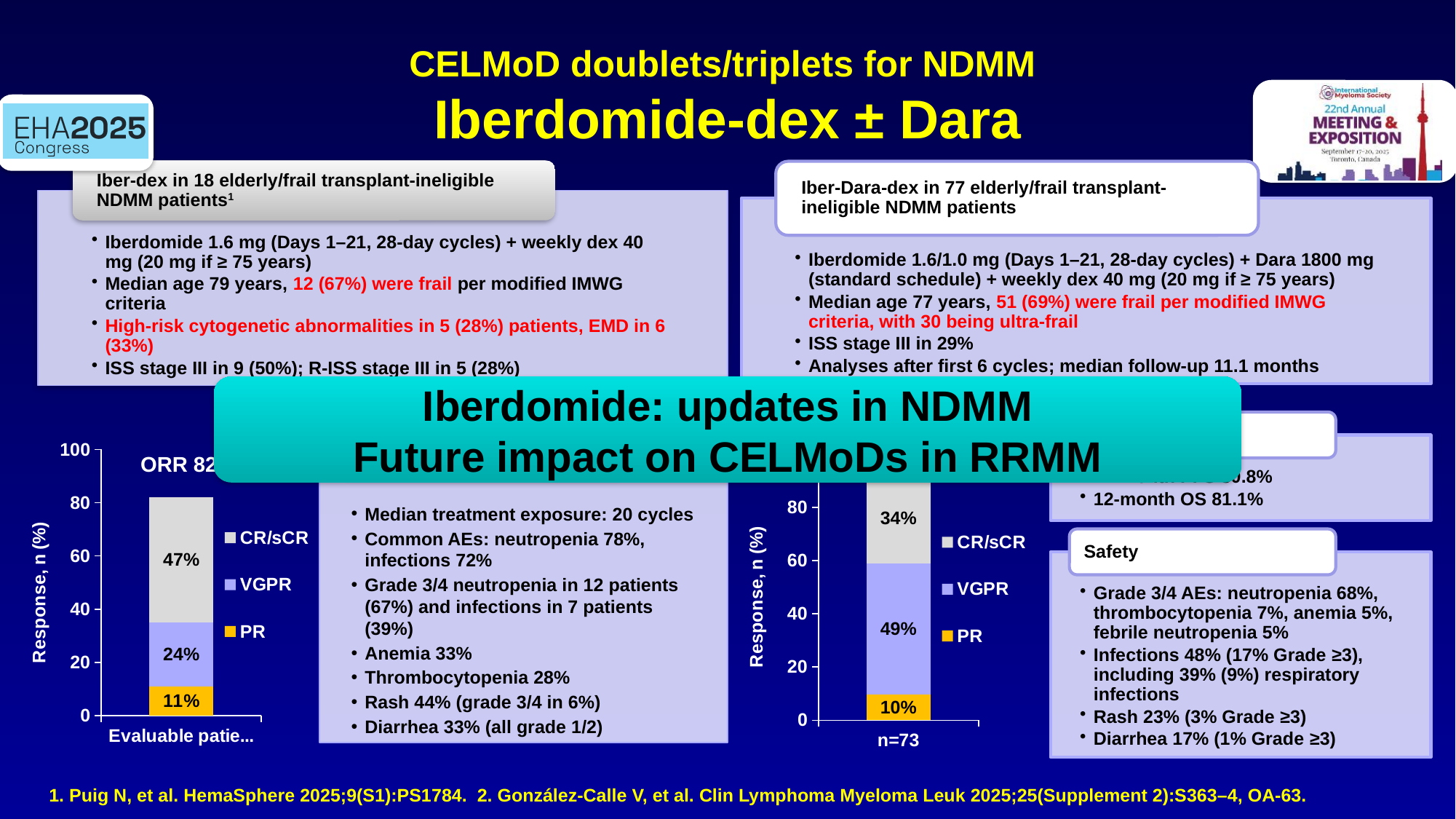
How many series does the legend of the right chart list? 3 In the right chart (n=73), which response category has the smallest segment? PR In the left chart, what is the value for CR/sCR? 47% In the right chart (n=73), what is the value for PR? 10% What kind of chart is the left chart? Stacked bar chart In the left chart, what is the value for VGPR? 24% In the right chart (n=73), what is the value for VGPR? 49% In the left chart, which response category has the largest segment? CR/sCR In the left chart, what is the value for PR? 11% In the right chart (n=73), what is the difference between the VGPR and CR/sCR values? 15% In the left chart, what is the total of the stacked bar? 82% In the right chart (n=73), what is the value for CR/sCR? 34%